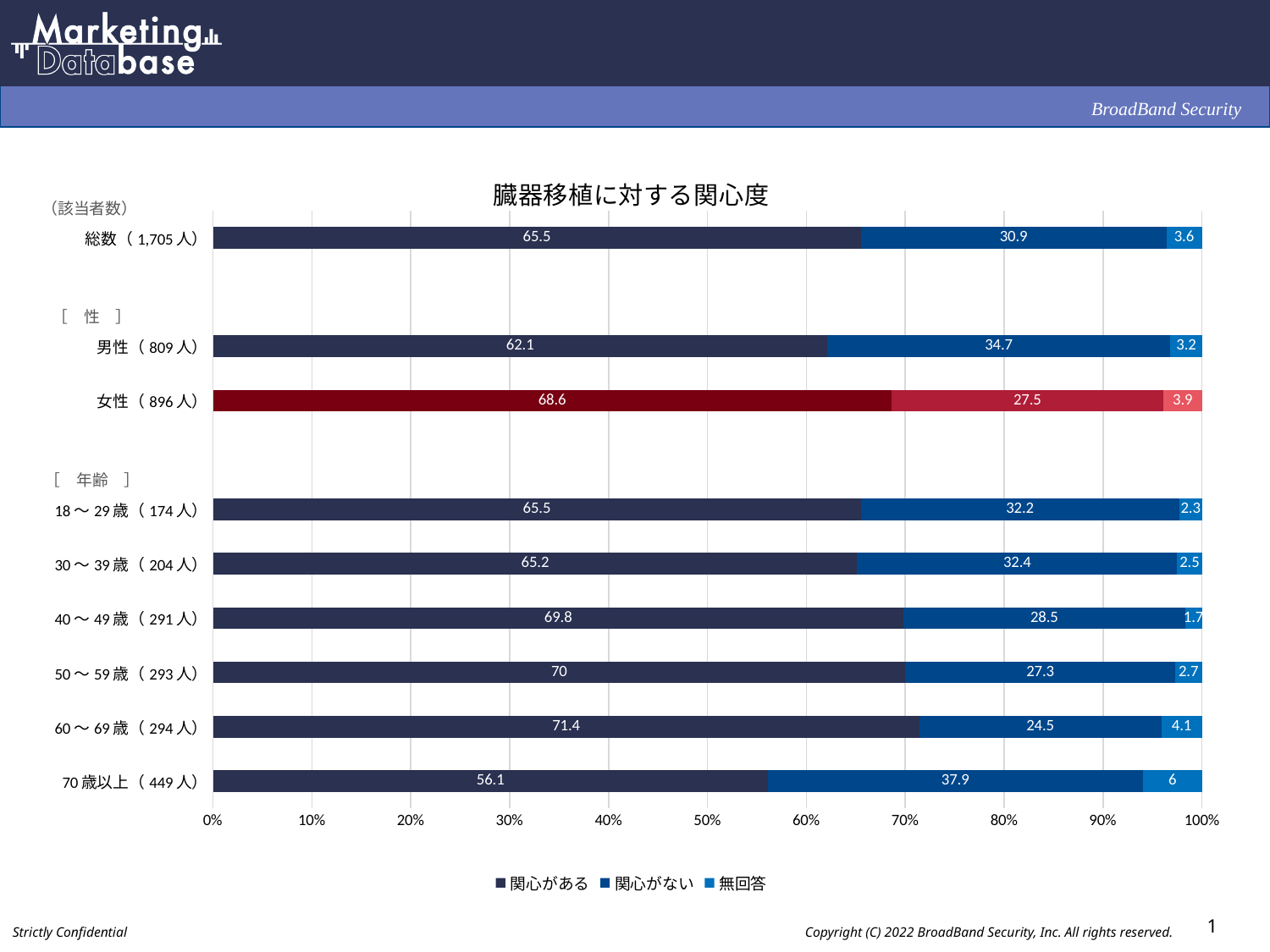
What is the difference between the 関心がある values for 女性 and 男性? 6.5 What is the value of 関心がない for 70歳以上? 37.9 How many categories are plotted in the chart? 9 How many series does the legend list? 3 Which is larger, the 関心がない value for 男性 or for 女性? 男性 What is the value of 関心がある for 総数? 65.5 What kind of chart is shown on the slide? Stacked bar chart What is the value of 無回答 for 女性? 3.9 Which category has the lowest value for 関心がある? 70歳以上 Which category has the highest value for 関心がある? 60～69歳 What is the value of 関心がある for 60～69歳? 71.4 Which category has the highest value for 無回答? 70歳以上